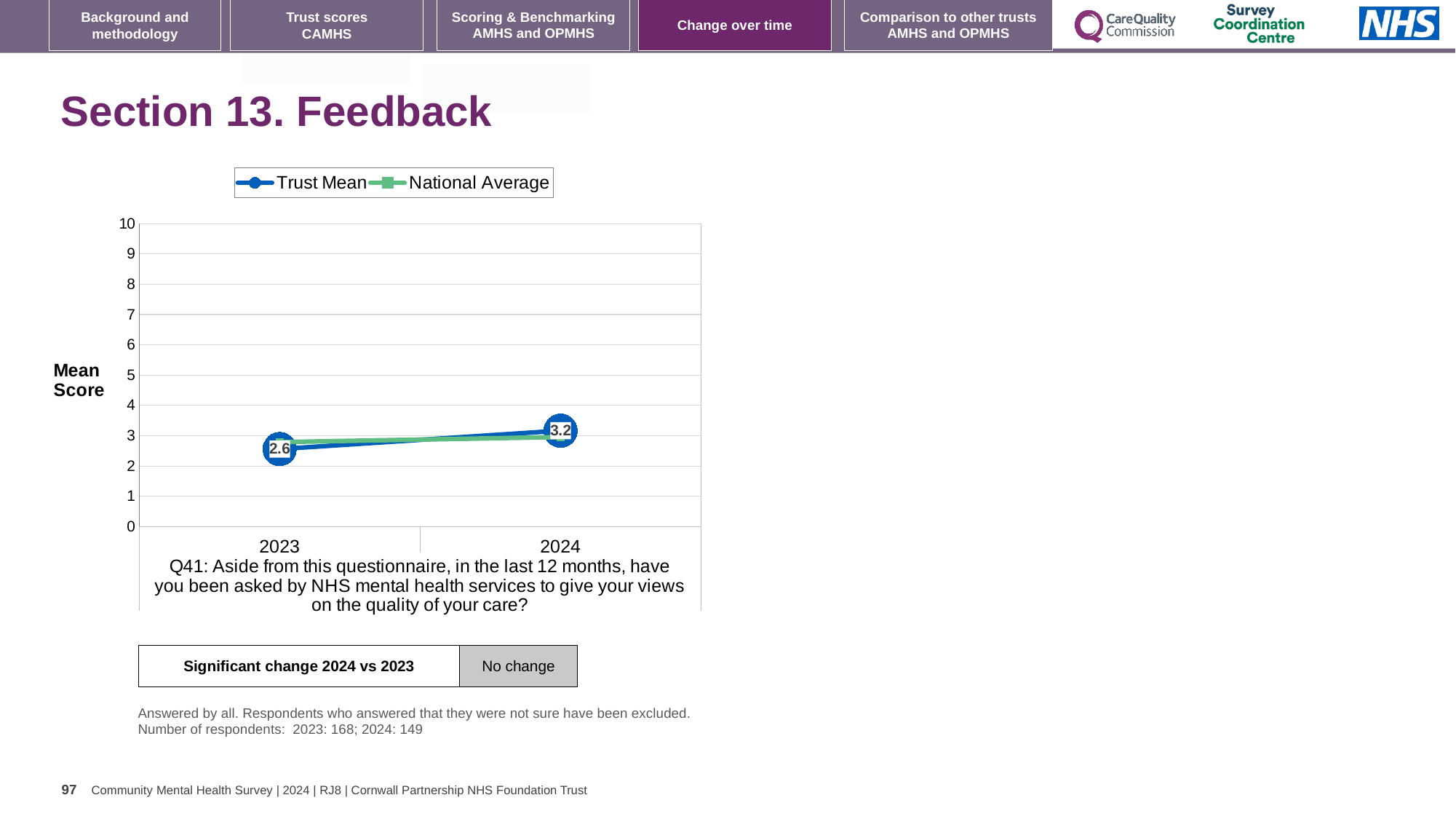
Does the Trust Mean line rise or fall from 2023 to 2024? rise What is the Trust Mean score for 2023? 2.6 What type of chart is shown on the slide? line chart How many years are shown on the x axis of the chart? 2 How many series does the chart legend list? 2 What is the Trust Mean score for 2024? 3.2 Is the National Average value for 2024 greater or less than 5? less Which year has the higher Trust Mean score, 2023 or 2024? 2024 Is the Trust Mean value for 2023 greater or less than 3? less Is the National Average value for 2023 greater or less than 2? greater By how much did the Trust Mean score change from 2023 to 2024? 0.6 What is the label of the y axis of the chart? Mean Score